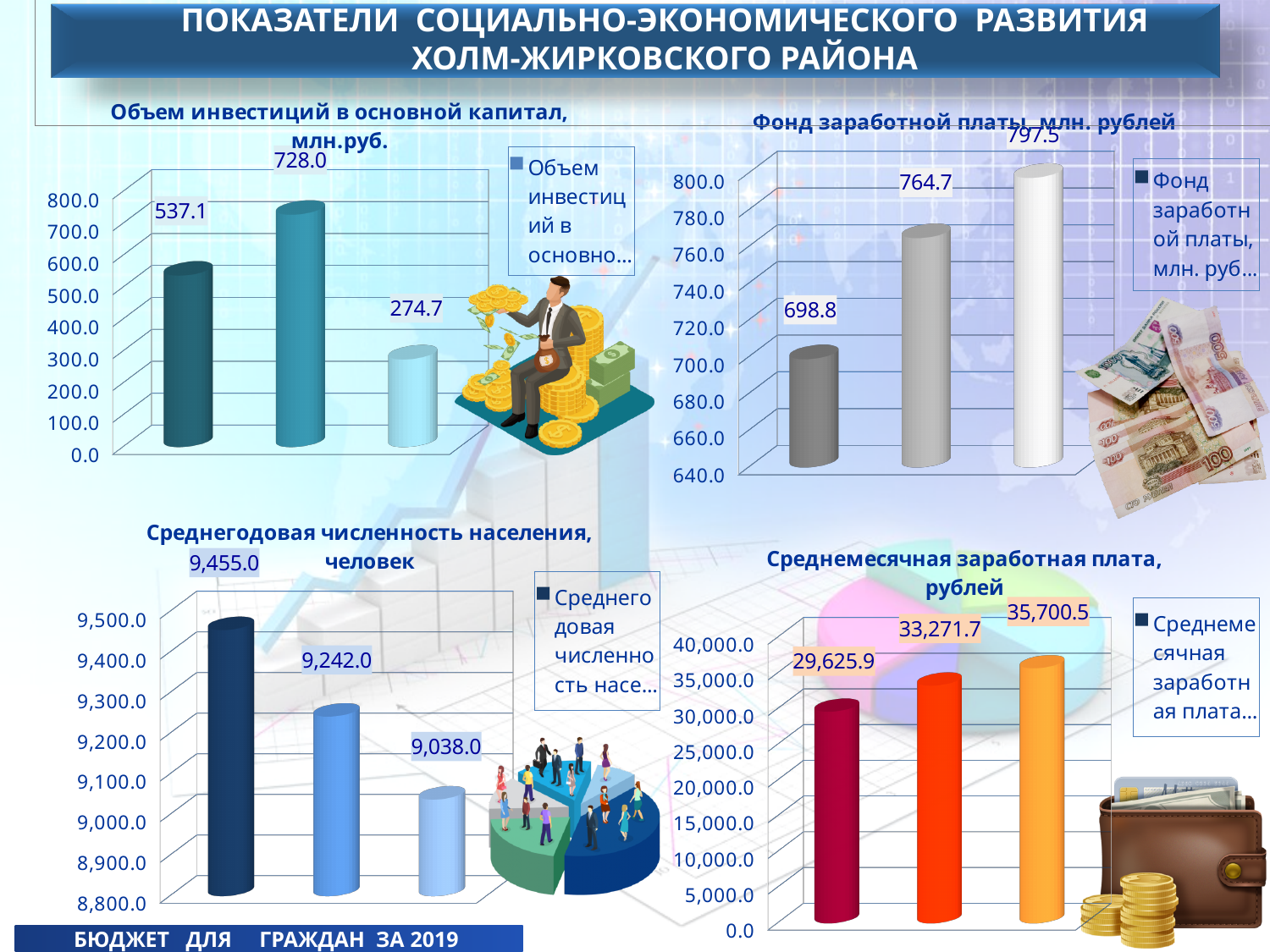
In the chart 'Объем инвестиций в основной капитал, млн.руб.', what is the value of the middle bar? 728.0 In the chart 'Среднемесячная заработная плата, рублей', what is the value of the middle bar? 33,271.7 In the chart 'Среднегодовая численность населения, человек', do the values rise or fall from left to right? fall In the chart 'Фонд заработной платы, млн. рублей', do the values rise or fall from left to right? rise In the chart 'Объем инвестиций в основной капитал, млн.руб.', which bar is the lowest? the right (third) bar, 274.7 In the chart 'Фонд заработной платы, млн. рублей', what is the value of the left bar? 698.8 In the chart 'Среднегодовая численность населения, человек', what is the value of the right bar? 9,038.0 In the chart 'Фонд заработной платы, млн. рублей', what is the difference between the highest and lowest bars? 98.7 In the chart 'Среднемесячная заработная плата, рублей', what is the difference between the right bar and the left bar? 6,074.6 How many bars does the chart 'Среднемесячная заработная плата, рублей' contain? 3 In the chart 'Объем инвестиций в основной капитал, млн.руб.', what is the difference between the middle bar and the right bar? 453.3 In the chart 'Среднегодовая численность населения, человек', which bar is the highest? the left (first) bar, 9,455.0